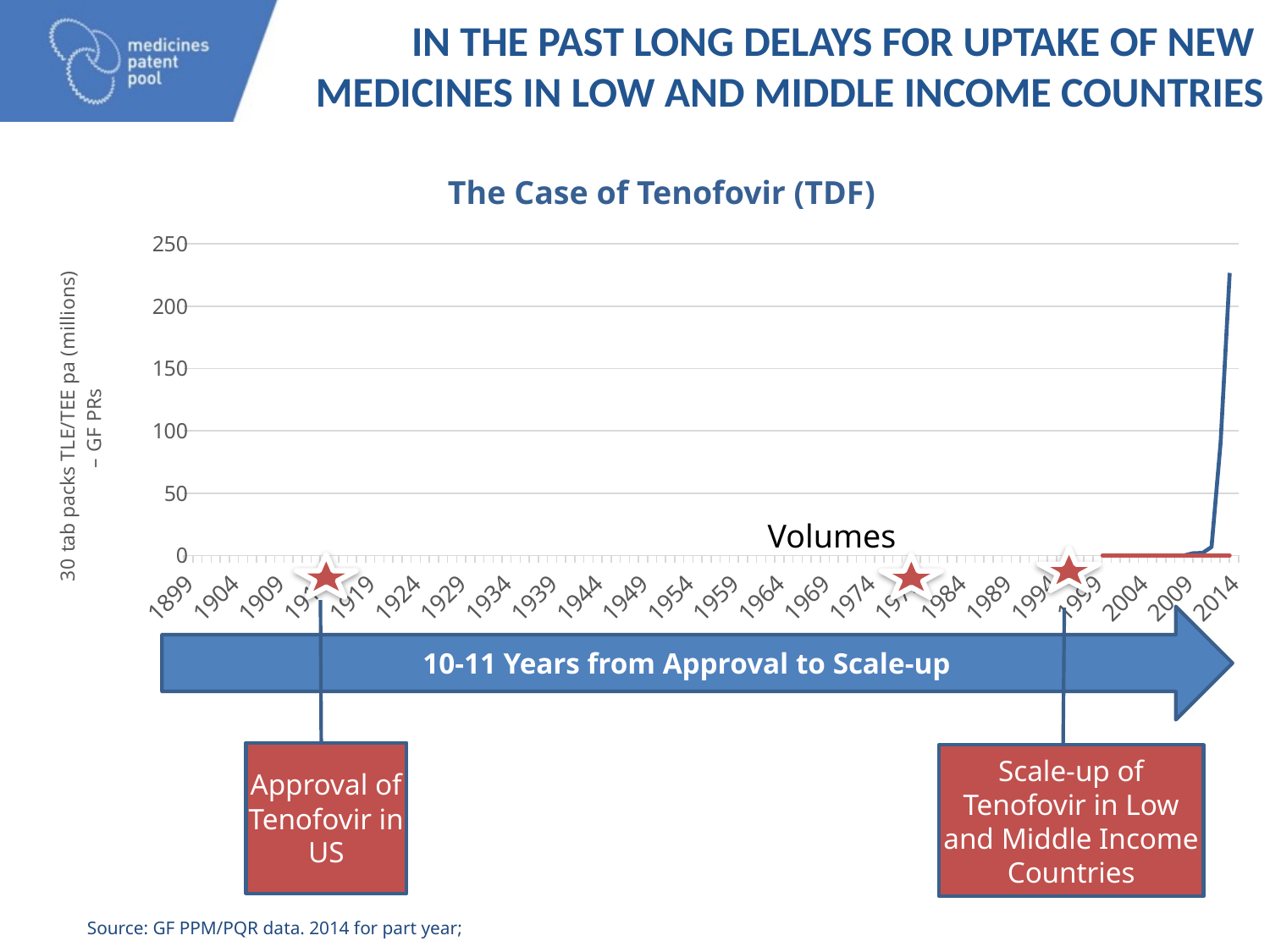
What is the title of the chart? The Case of Tenofovir (TDF) What is the last year shown on the x axis? 2014 Is the value of the blue line at 2014 greater or less than 200? greater What is the highest value shown on the y axis? 250 Does the blue line rise or fall between 2009 and 2014? rise What is the first year shown on the x axis? 1899 Which year on the x axis has the highest value for the blue line? 2014 What kind of chart is shown on the slide? line chart Is the value of the blue line at 2009 greater or less than 50? less How many year labels are shown on the x axis? 24 Is the value of the blue line at 2014 greater or less than 250? less